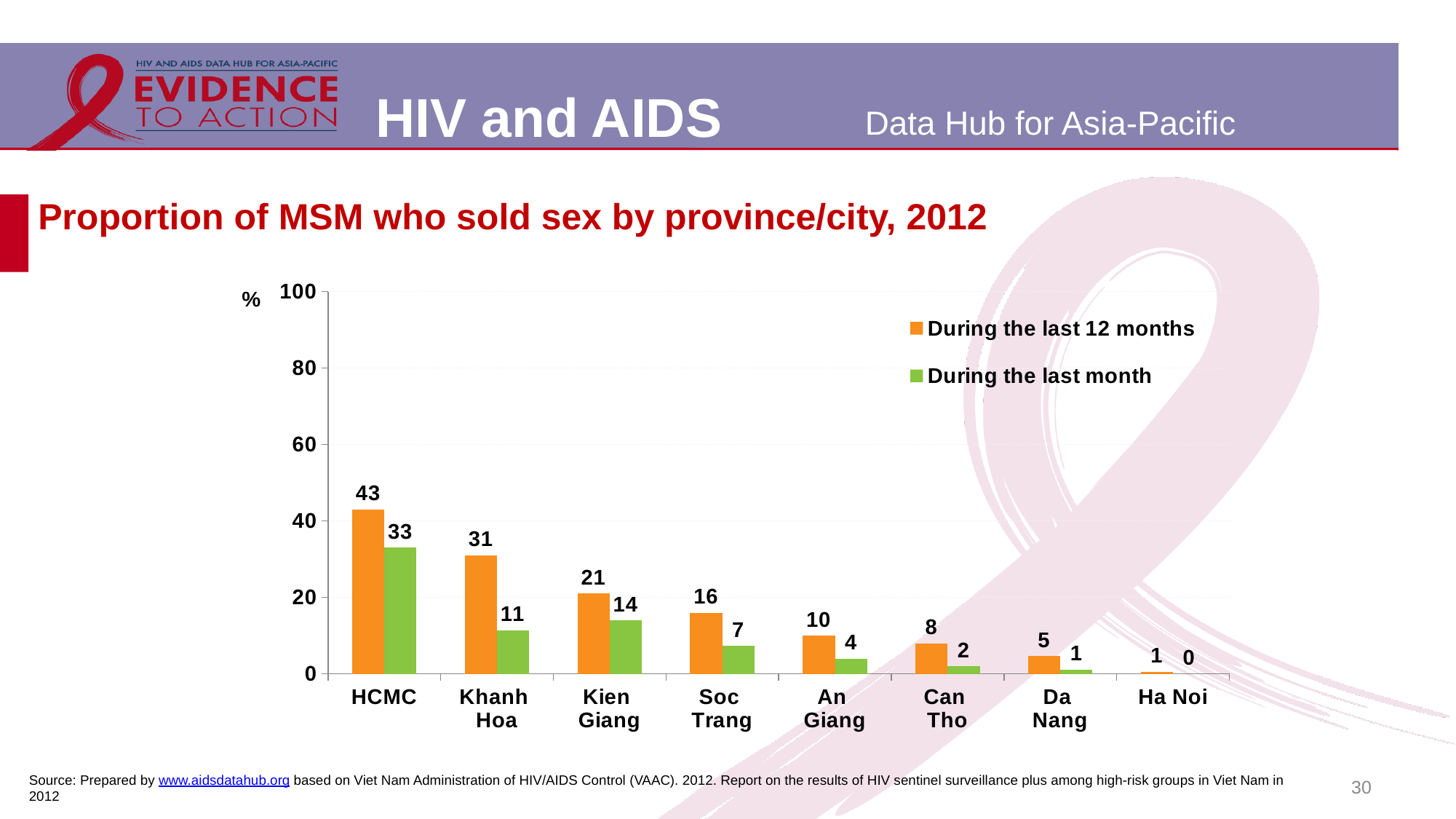
How many series does the legend list? 2 What kind of chart is shown on the slide? Bar chart What is the value for HCMC in the 'During the last 12 months' series? 43 Which province/city has the highest value in the 'During the last 12 months' series? HCMC What is the difference between the 'During the last 12 months' and 'During the last month' values for Kien Giang? 7 How many provinces/cities are shown on the x axis? 8 What is the value for Soc Trang in the 'During the last 12 months' series? 16 What colour represents the 'During the last month' series? Green Which is larger: the 'During the last month' value for HCMC or the 'During the last 12 months' value for Khanh Hoa? During the last month value for HCMC Do the 'During the last 12 months' values rise or fall from HCMC to Ha Noi along the x axis? Fall Which province/city has the lowest value in the 'During the last month' series? Ha Noi What is the value for Khanh Hoa in the 'During the last month' series? 11